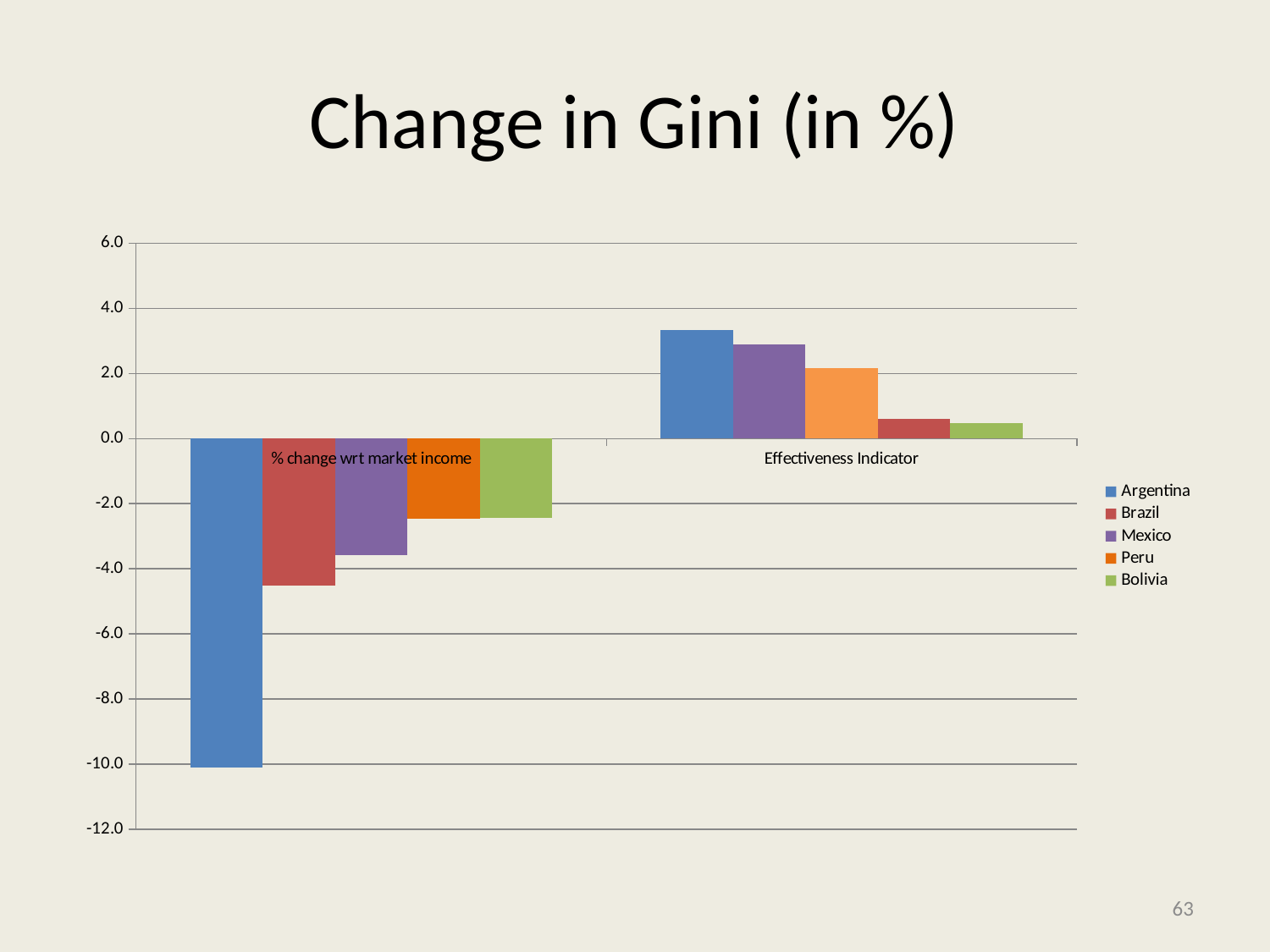
Is the value for Mexico under % change wrt market income greater or less than -4.0? greater Is the value for Argentina under % change wrt market income greater or less than -8.0? less How many categories are shown on the x axis? 2 What kind of chart is shown on the slide? bar chart How many series does the legend list? 5 Which country has the highest value for Effectiveness Indicator? Argentina Is the value for Brazil under % change wrt market income greater or less than -4.0? less What is the title of the chart? Change in Gini (in %) Which country has the lowest value for % change wrt market income? Argentina